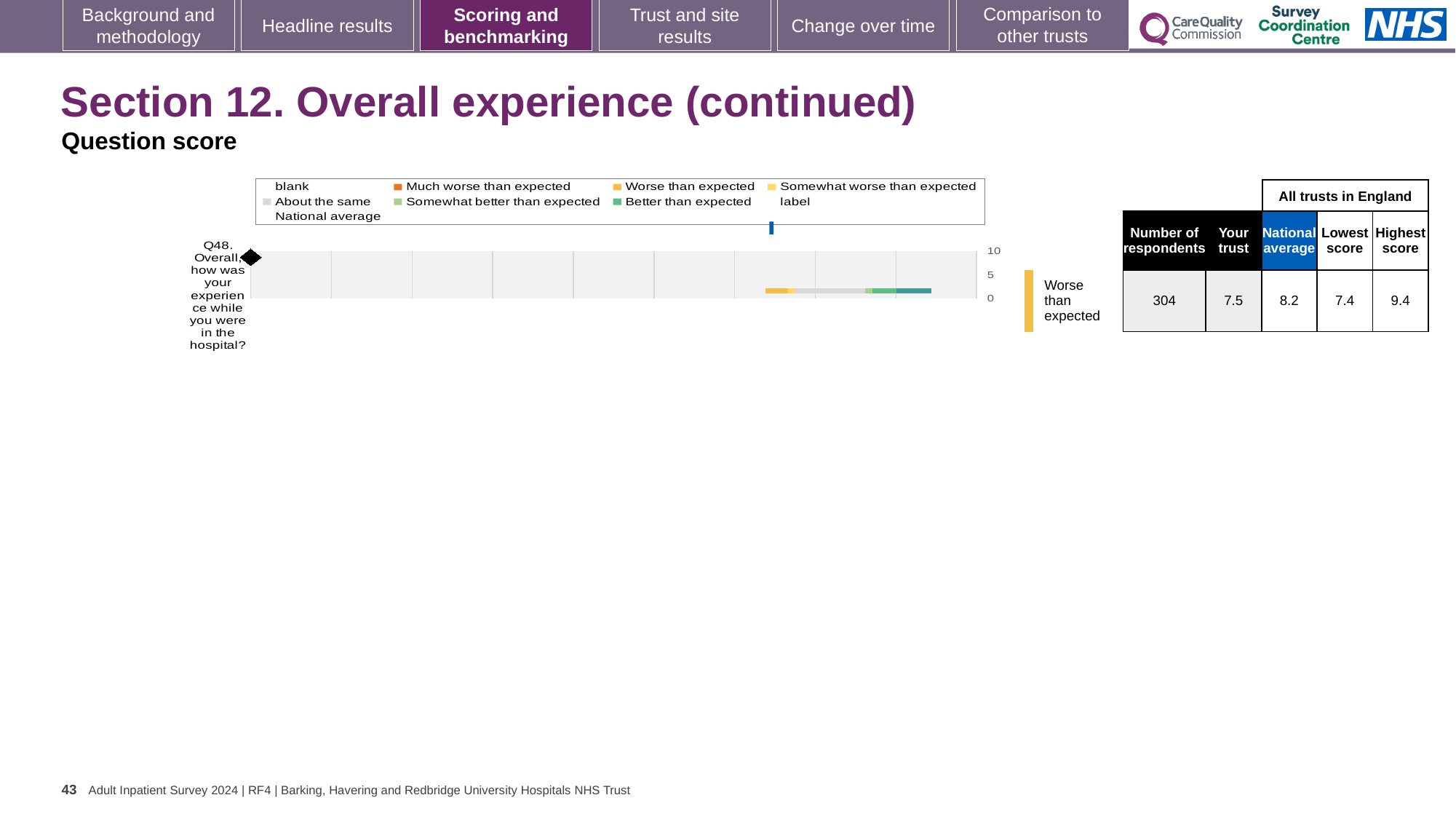
Which question is plotted on the chart? Q48. Overall, how was your experience while you were in the hospital? What is the highest score among all trusts in England for Q48? 9.4 How many survey questions are plotted on the chart? 1 What is the national average score for Q48? 8.2 Which is larger for Q48, the 'Your trust' score or the national average? National average How many respondents answered Q48? 304 What is the 'Your trust' score for Q48? 7.5 What kind of chart is used to show the Q48 question score? bar chart What is the difference between the highest and lowest scores for Q48? 2.0 What benchmark category label is shown beside the chart for Q48? Worse than expected What is the difference between the national average and the 'Your trust' score for Q48? 0.7 What is the lowest score among all trusts in England for Q48? 7.4